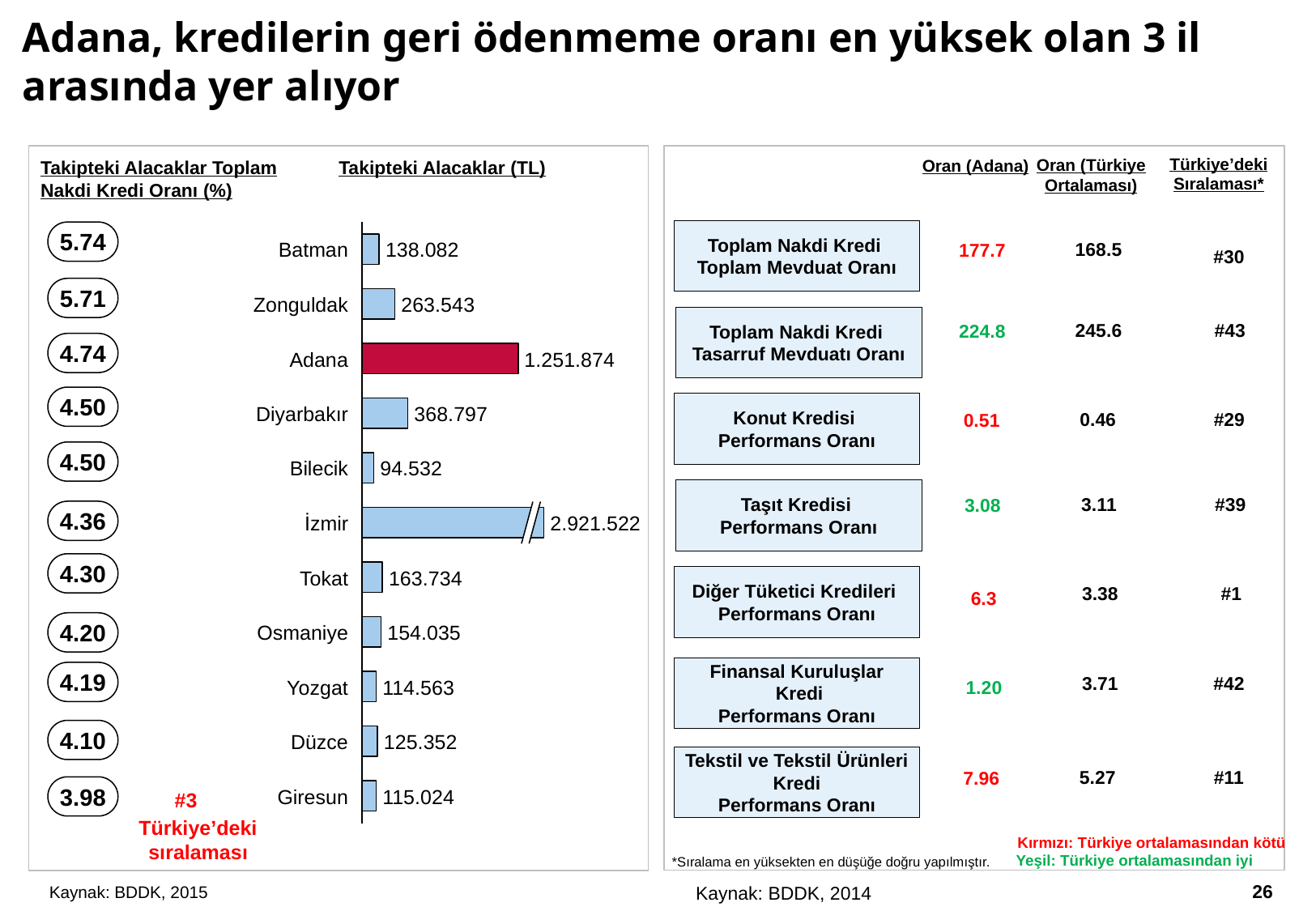
What is the difference between the Takipteki Alacaklar (TL) values of Zonguldak and Batman? 125.461 How many cities are plotted in the "Takipteki Alacaklar (TL)" bar chart? 11 What is the Takipteki Alacaklar Toplam Nakdi Kredi Oranı (%) shown for Adana? 4.74 Which has a larger Takipteki Alacaklar (TL) value, Tokat or Osmaniye? Tokat What is the Takipteki Alacaklar (TL) value for Giresun? 115.024 What type of chart is shown under the heading "Takipteki Alacaklar (TL)"? bar chart What is the difference between the Takipteki Alacaklar (TL) values of Adana and Diyarbakır? 883.077 Which city has the lowest Takipteki Alacaklar (TL) value in the bar chart? Bilecik Which city has the highest Takipteki Alacaklar (TL) value in the bar chart? İzmir Which city's bar is highlighted in red in the "Takipteki Alacaklar (TL)" bar chart? Adana What is the Takipteki Alacaklar (TL) value for Adana? 1.251.874 What is the Takipteki Alacaklar (TL) value for Diyarbakır? 368.797